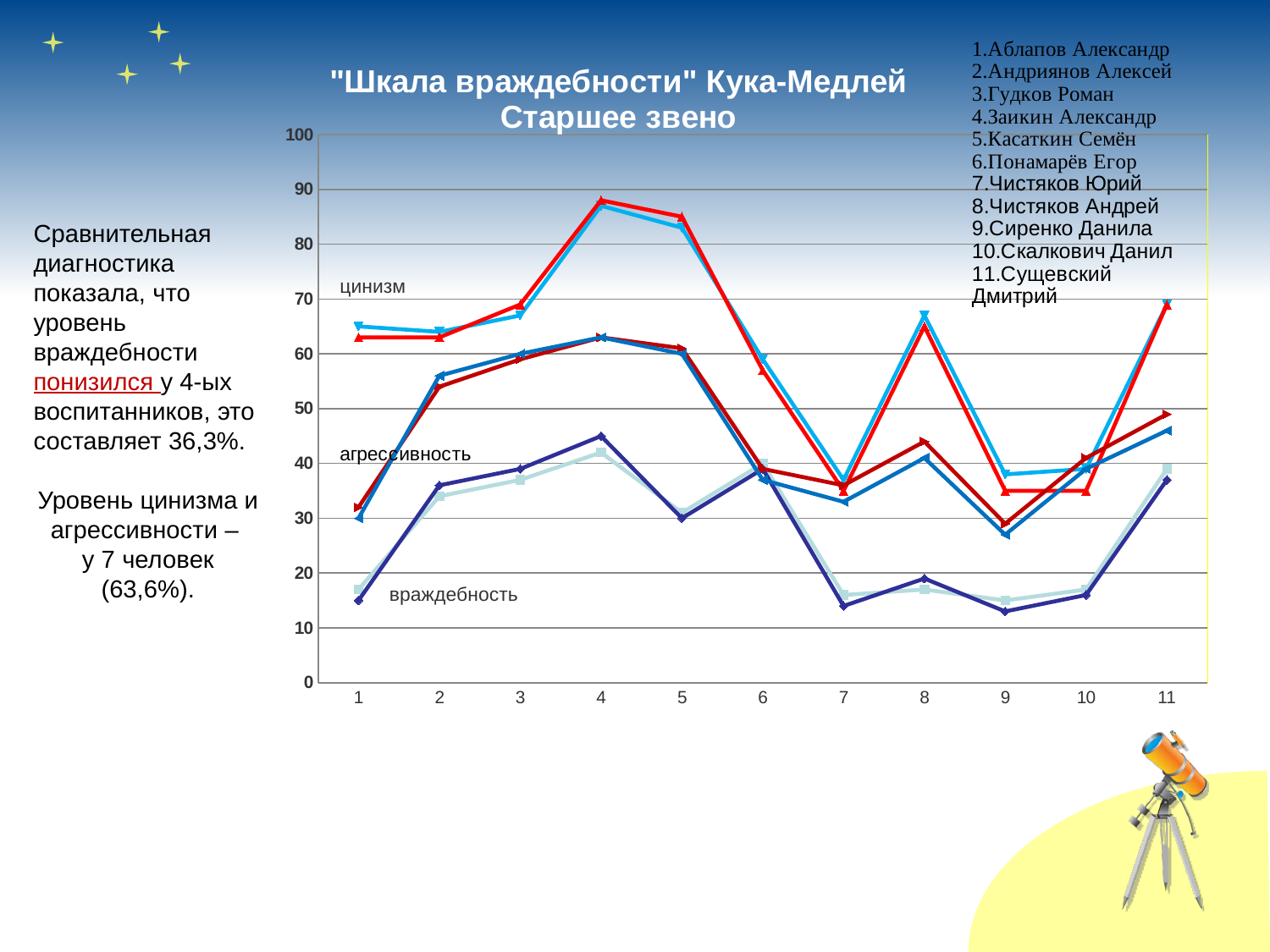
Does the red line rise or fall from category 4 to category 7? fall Which group of lines is labelled "цинизм" on the chart: the top, middle or bottom group? top How many numbered categories are shown along the x axis of the chart? 11 Is the value of the light blue line at category 1 greater or less than 60? greater Does the light blue line rise or fall from category 1 to category 4? rise What kind of chart is shown on the slide? line chart At which category does the red line reach its highest value? 4 Is the value of the dark purple line at category 1 greater or less than 20? less Is the value of the dark purple line at category 7 greater or less than 20? less What is the title of the chart? "Шкала враждебности" Кука-Медлей Старшее звено